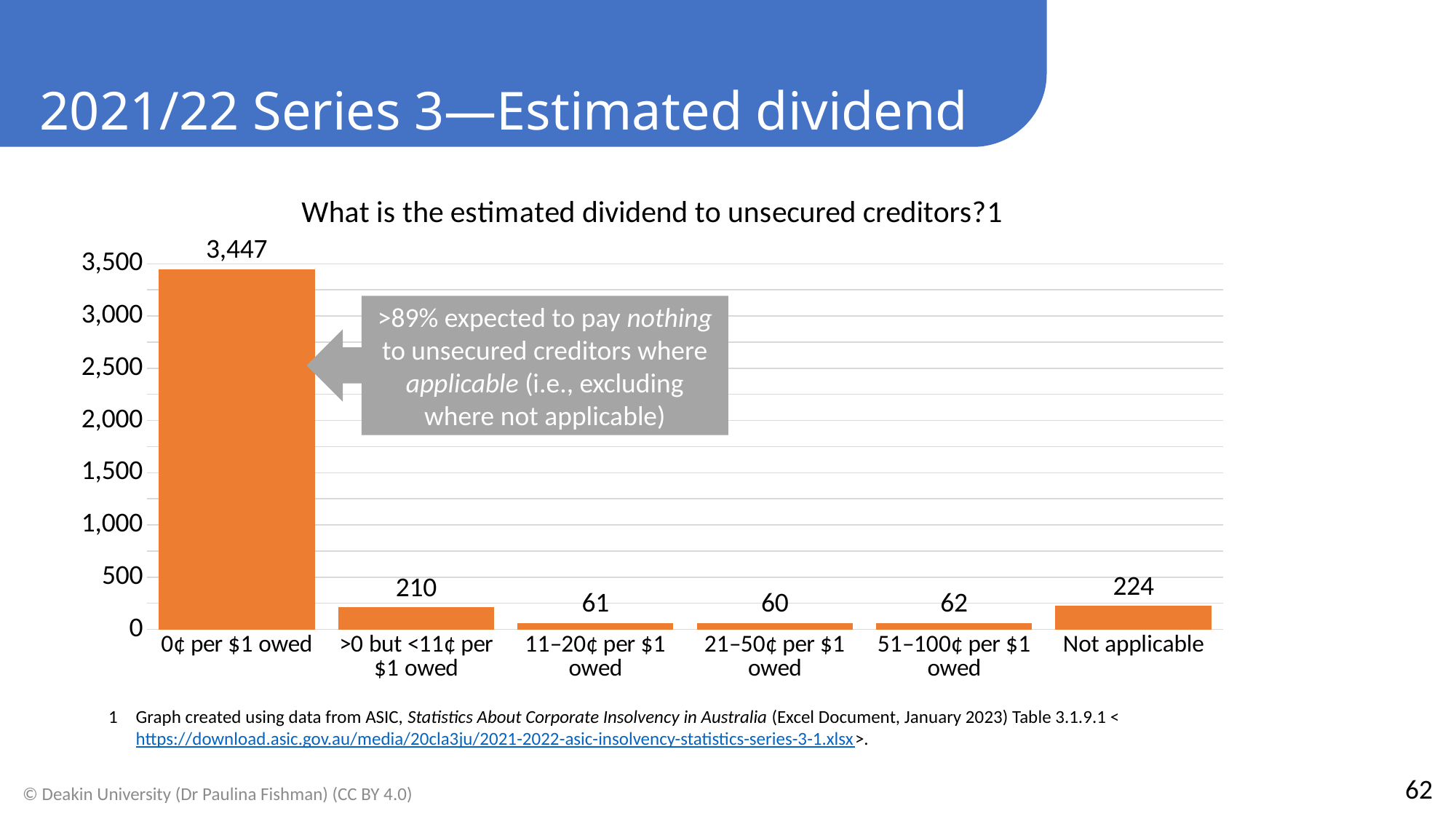
What is the difference between the values for '0¢ per $1 owed' and 'Not applicable'? 3,223 How many categories are shown on the x axis? 6 Which is larger: the value for 'Not applicable' or the value for '>0 but <11¢ per $1 owed'? Not applicable What is the value for the 'Not applicable' category? 224 What is the title of the chart? What is the estimated dividend to unsecured creditors? Which category has the lowest value? 21–50¢ per $1 owed What is the value for the '0¢ per $1 owed' category? 3,447 Which category has the highest value? 0¢ per $1 owed What kind of chart is shown on the slide? bar chart What is the value for the '21–50¢ per $1 owed' category? 60 Is the value for '0¢ per $1 owed' greater or less than 3,000? greater What is the value for the '>0 but <11¢ per $1 owed' category? 210